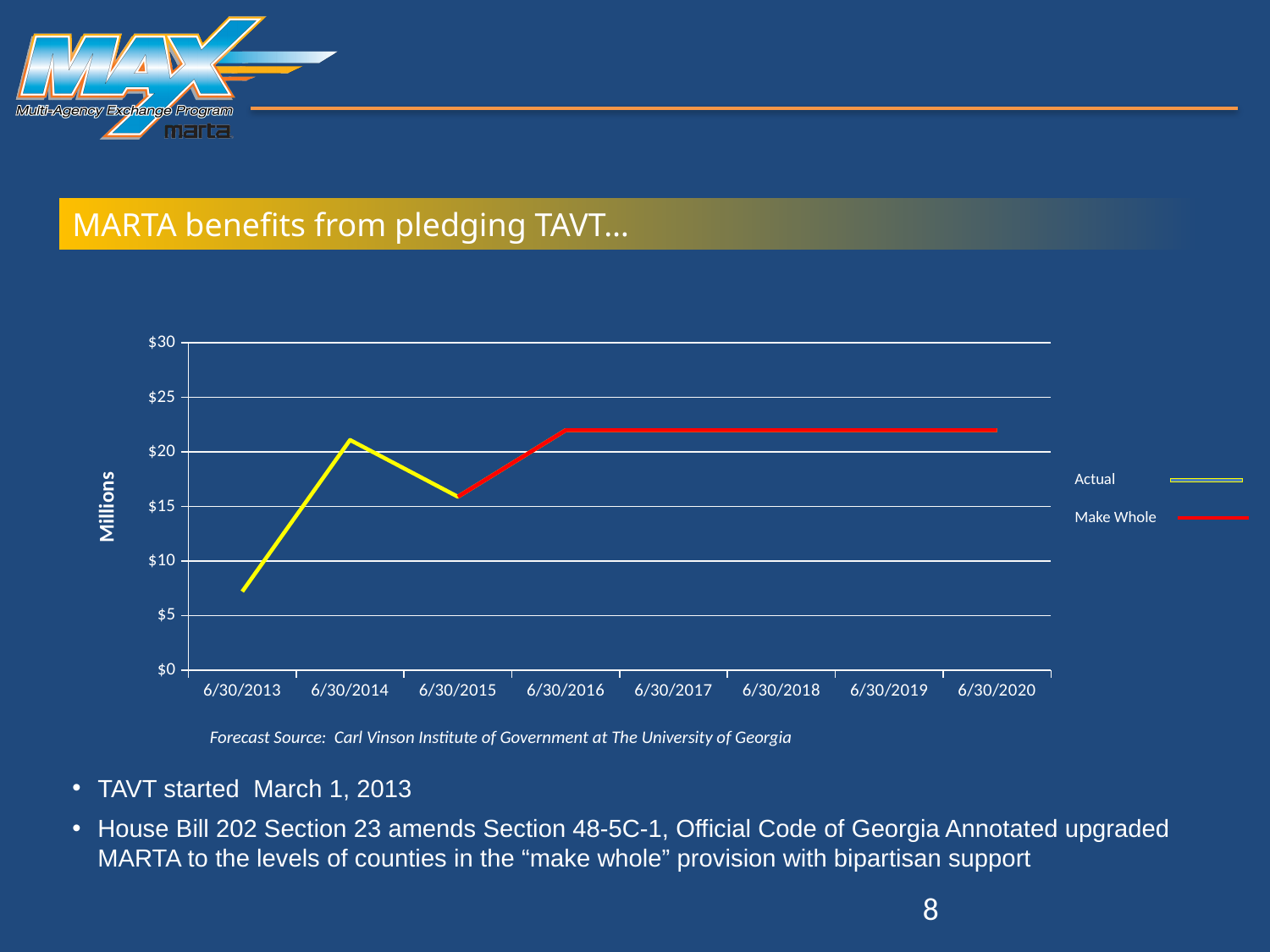
Is the Make Whole value at 6/30/2020 greater or less than $25? less What kind of chart is shown on the slide? line chart How many dates are shown along the x axis of the chart? 8 Does the Actual series rise or fall from 6/30/2013 to 6/30/2014? rise Which is larger, the Actual value at 6/30/2014 or the Actual value at 6/30/2015? 6/30/2014 How many series does the chart legend list? 2 Is the Actual value at 6/30/2014 greater or less than $20? greater Is the Make Whole value at 6/30/2016 greater or less than $20? greater At which date is the Actual series at its lowest value? 6/30/2013 What is the label on the vertical axis of the chart? Millions